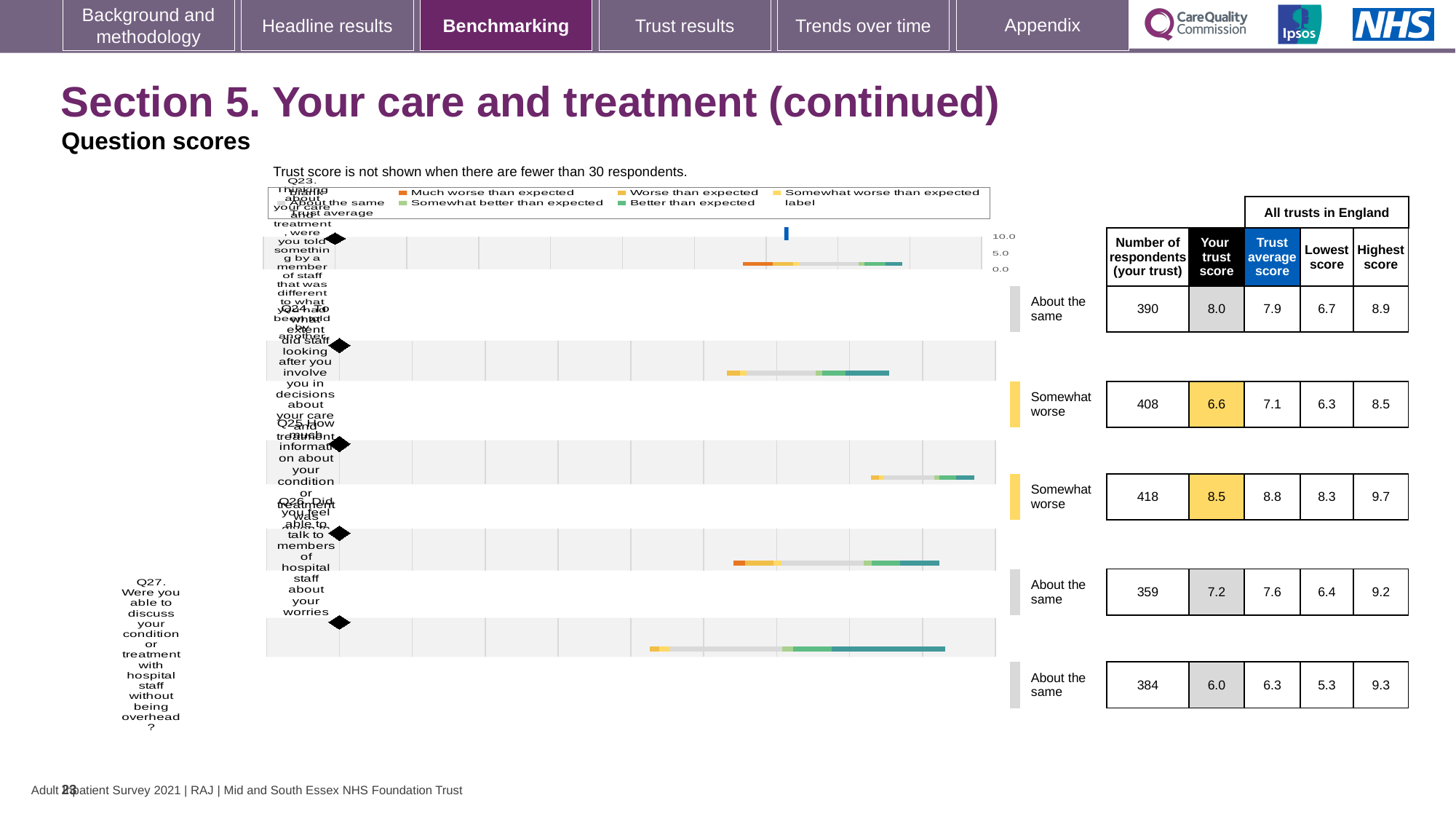
What is the difference between the trust average score and your trust score for Q24? 0.5 Which question has the highest 'Your trust score' on this slide? Q25 How many respondents from your trust answered Q25? 418 What is the trust average score for Q27 (were you able to discuss your condition or treatment with hospital staff without being overheard)? 6.3 What kind of chart is used to show the question scores on this slide? bar chart What is the lowest score among all trusts in England for Q23? 6.7 How many questions (Q23 to Q27) are plotted on this slide? 5 What is the 'Your trust score' for Q24 (to what extent did staff looking after you involve you in decisions about your care and treatment)? 6.6 Which benchmark category is shown for Q24 and Q25? Somewhat worse What is the highest score among all trusts in England for Q26? 9.2 Is your trust score for Q23 larger or smaller than the trust average score for Q23? larger Which question has the lowest 'Your trust score' on this slide? Q27